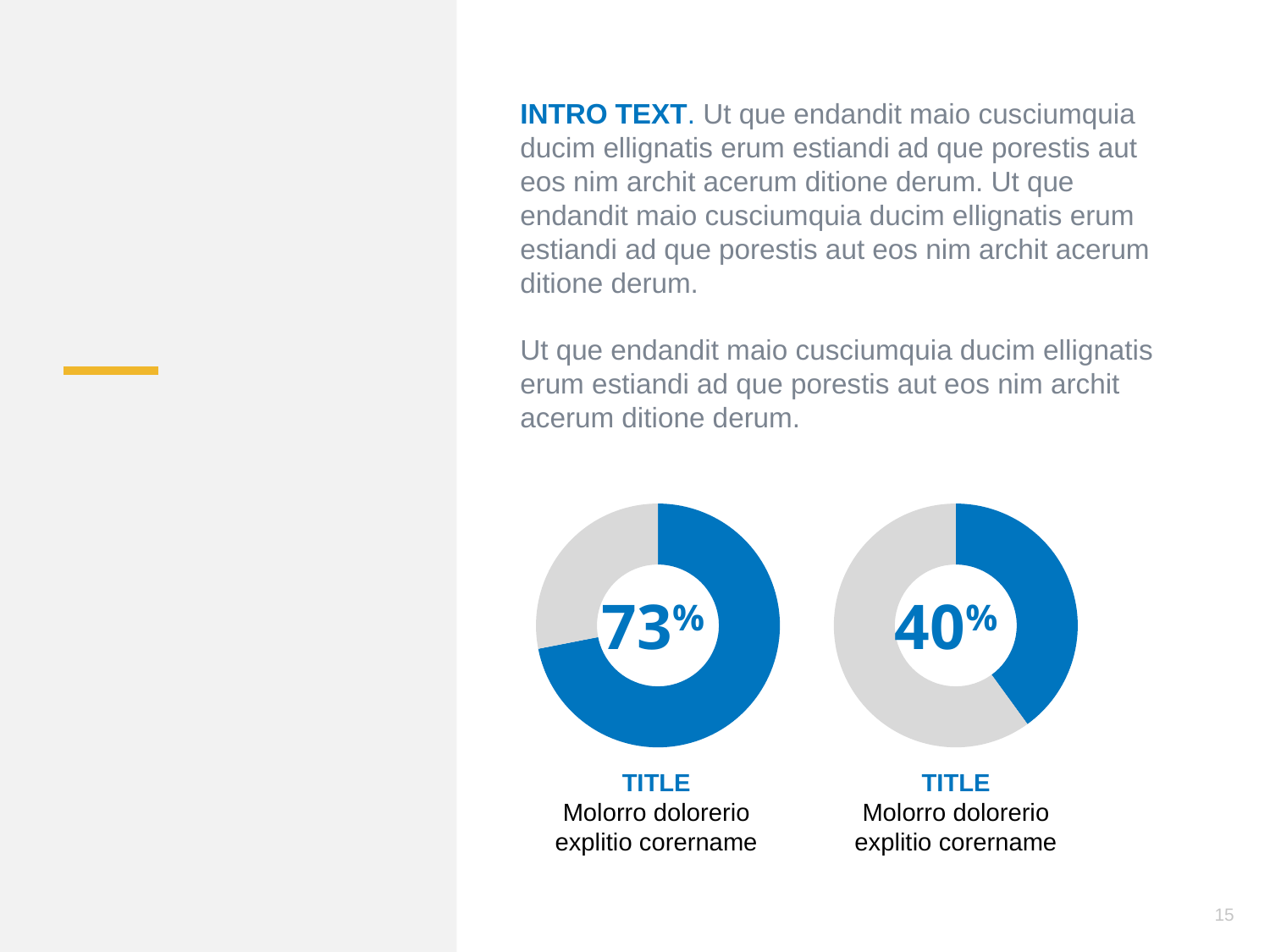
What is the difference between the percentage in the left donut chart and the percentage in the right donut chart? 33% In the left donut chart, what share of the ring is filled in blue? 73% How many donut charts are shown on the slide? 2 Is the value shown in the left donut chart greater or less than 50%? greater What colour is the filled portion of the ring in both donut charts? blue What percentage is shown in the centre of the left donut chart? 73% In the right donut chart, what share of the ring is filled in blue? 40% What kind of chart is used on the left side of the slide? donut chart Is the value shown in the right donut chart greater or less than 50%? less What kind of chart is used on the right side of the slide? donut chart Which donut chart shows the larger percentage, the left one or the right one? the left one What percentage is shown in the centre of the right donut chart? 40%